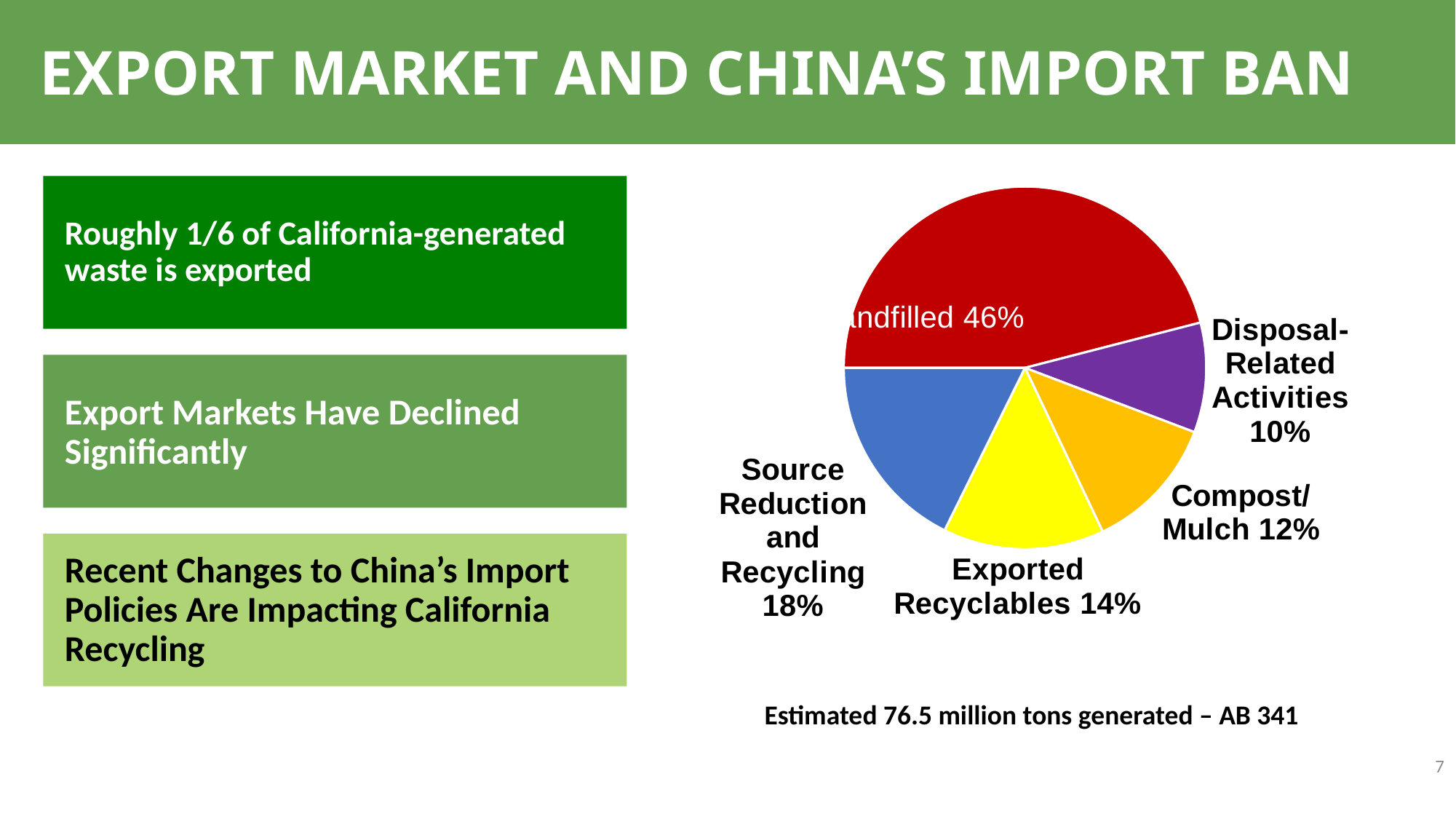
What kind of chart is shown on the slide? Pie chart Which category has the smallest share of the pie? Disposal-Related Activities What share of the pie is Landfilled? 46% What colour is the Landfilled slice? Red What percentage is shown for Source Reduction and Recycling? 18% What percentage is shown for Exported Recyclables? 14% What is the difference in percentage points between Landfilled and Source Reduction and Recycling? 28 What percentage is shown for Compost/Mulch? 12% Which category has the largest share of the pie? Landfilled How many slices does the pie chart have? 5 Which is larger, Exported Recyclables or Compost/Mulch? Exported Recyclables What percentage is shown for Disposal-Related Activities? 10%